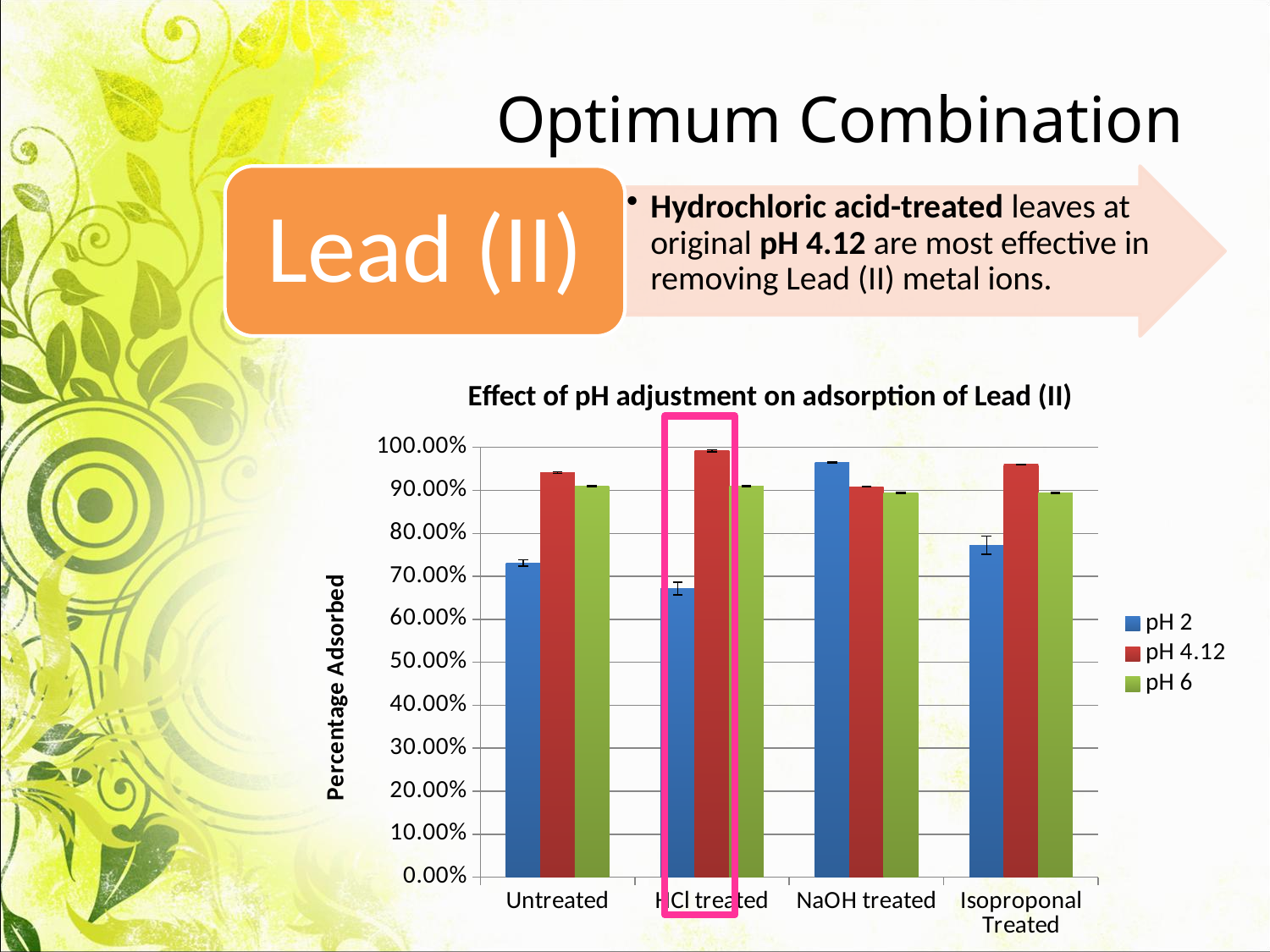
How many treatment categories are shown on the x axis? 4 Is the pH 2 value for HCl treated greater or less than 70.00%? less Which treatment category has the lowest pH 2 bar? HCl treated How many series does the chart's legend list? 3 Is the pH 2 value for NaOH treated greater or less than 90.00%? greater What kind of chart is shown on the slide? bar chart For NaOH treated, which is larger: the pH 2 value or the pH 6 value? pH 2 Is the pH 2 value for Untreated greater or less than 70.00%? greater For Untreated, which is larger: the pH 2 value or the pH 4.12 value? pH 4.12 Which treatment category has the highest pH 4.12 bar? HCl treated What is the label of the y axis? Percentage Adsorbed What is the title of the chart? Effect of pH adjustment on adsorption of Lead (II)